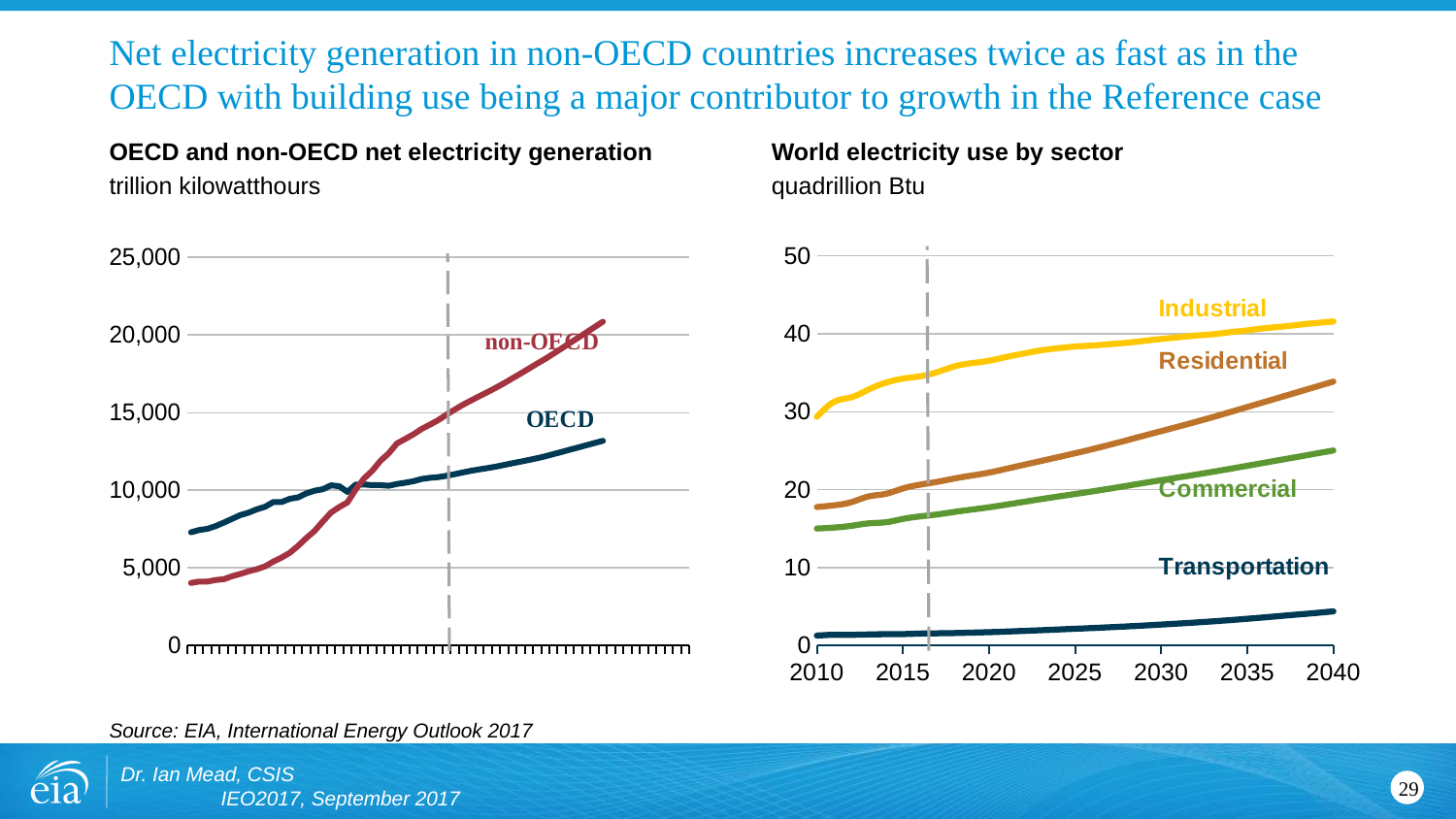
What unit is used on the 'World electricity use by sector' chart? quadrillion Btu How many series are plotted on the 'OECD and non-OECD net electricity generation' chart on the left? 2 On the 'OECD and non-OECD net electricity generation' chart, is the final value of the non-OECD line greater or less than 20,000? greater How many series are plotted on the 'World electricity use by sector' chart on the right? 4 On the 'World electricity use by sector' chart, is the value for Commercial in 2010 greater or less than 20? less What kind of chart is the 'OECD and non-OECD net electricity generation' chart on the left? line chart On the 'OECD and non-OECD net electricity generation' chart, is the final value of the OECD line greater or less than 15,000? less On the 'OECD and non-OECD net electricity generation' chart, which series is higher at the right end of the chart, OECD or non-OECD? non-OECD On the 'World electricity use by sector' chart, which sector has the lowest electricity use across the whole period? Transportation On the 'World electricity use by sector' chart, which sector has the highest electricity use in 2040? Industrial